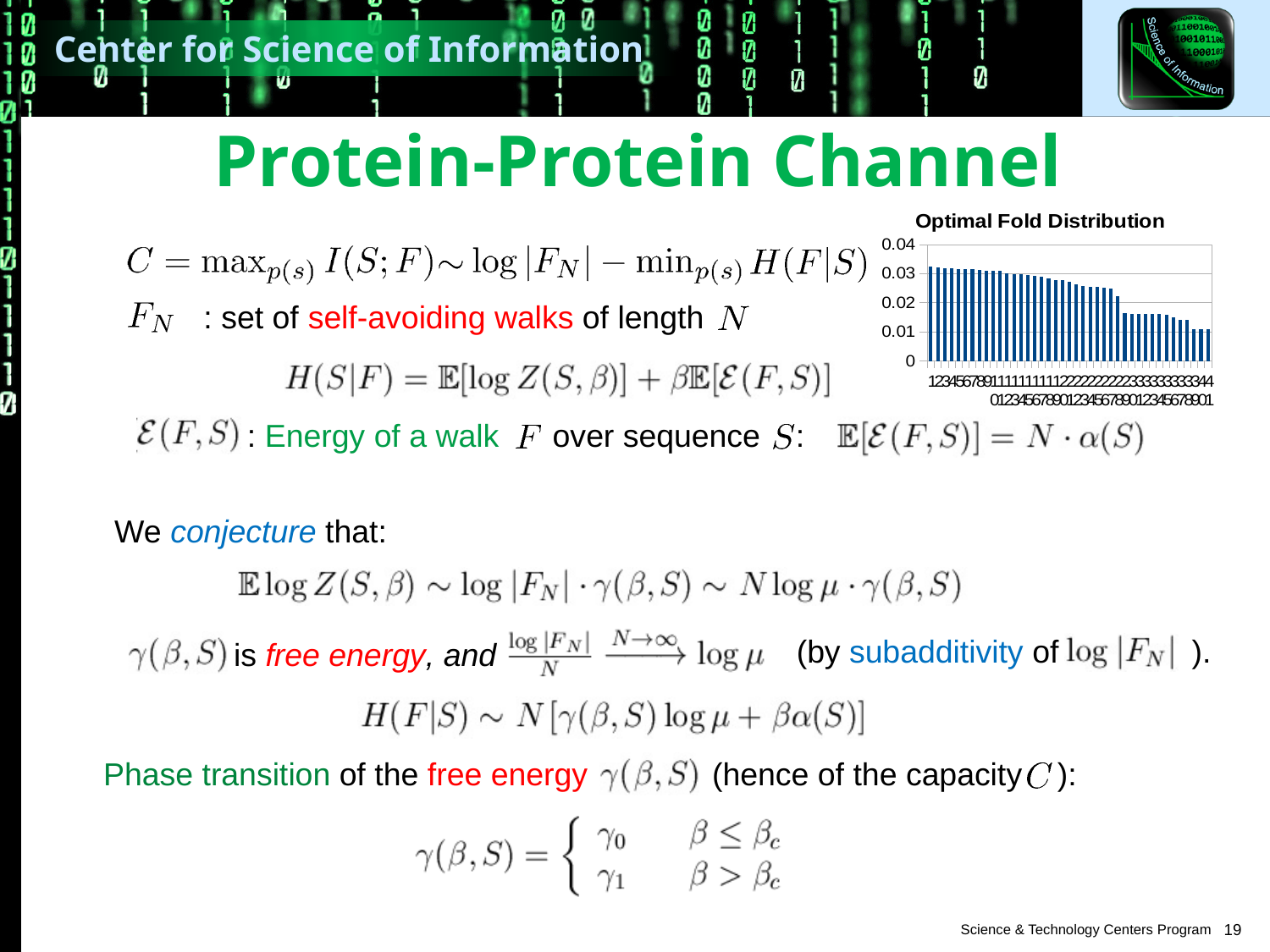
In the Optimal Fold Distribution chart, is the value for category 10 larger or smaller than the value for category 40? larger In the Optimal Fold Distribution chart, do the bar values rise or fall moving from left to right along the x axis? fall What is the highest tick value shown on the y axis of the Optimal Fold Distribution chart? 0.04 In the Optimal Fold Distribution chart, is the value of the rightmost bar greater or less than 0.02? less What kind of chart is shown on the slide? bar chart In the Optimal Fold Distribution chart, is the value for category 5 greater or less than 0.01? greater What is the title of the chart on the slide? Optimal Fold Distribution In the Optimal Fold Distribution chart, is the value for category 1 greater or less than 0.02? greater In the Optimal Fold Distribution chart, which bar is larger, the leftmost bar or the rightmost bar? the leftmost bar